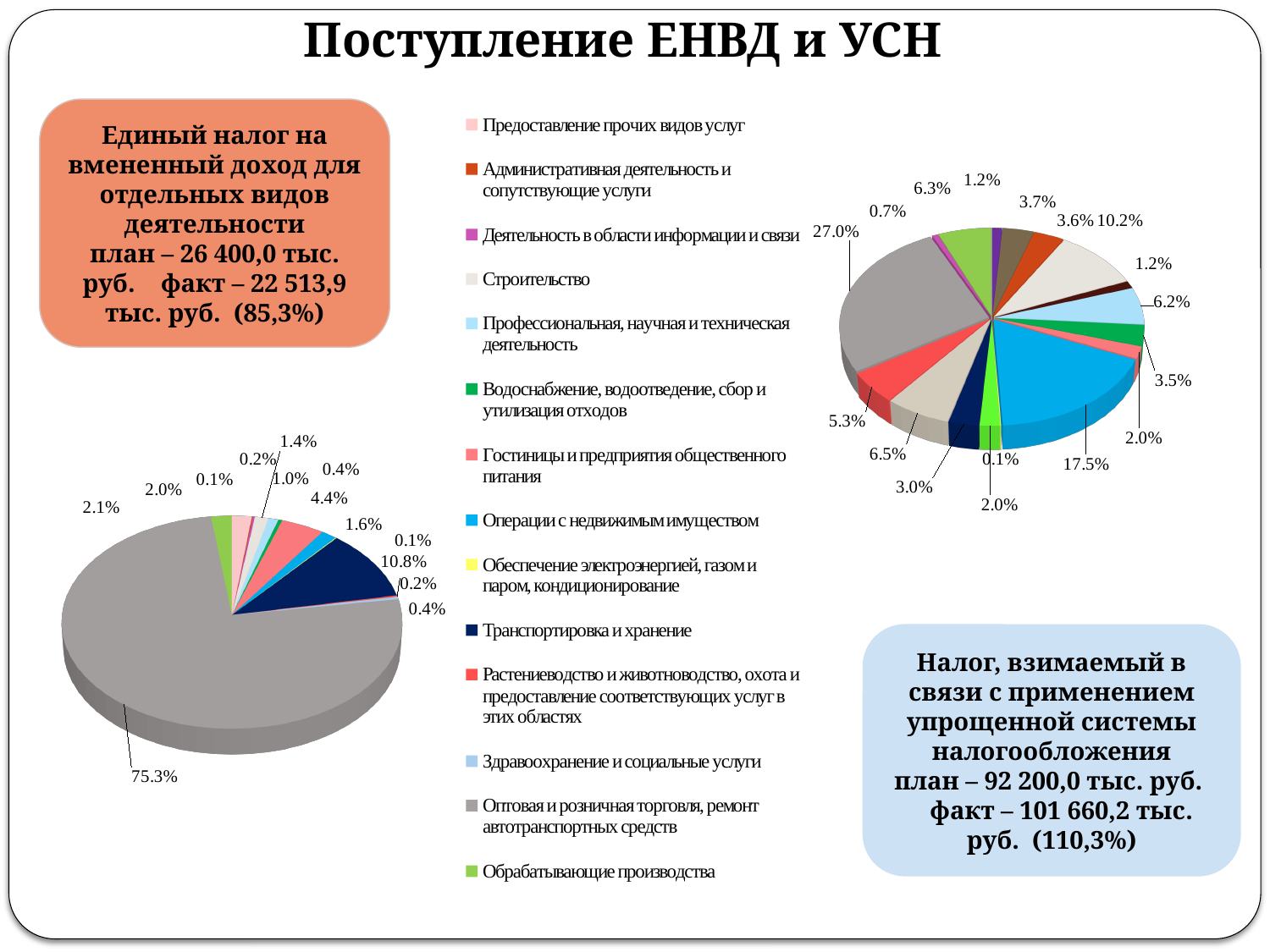
In the left pie chart (ЕНВД), what is the share of Оптовая и розничная торговля, ремонт автотранспортных средств? 75.3% In the right pie chart (УСН), what is the share of Операции с недвижимым имуществом? 17.5% In the left pie chart (ЕНВД), which category has the largest share? Оптовая и розничная торговля, ремонт автотранспортных средств In the right pie chart (УСН), which category has the largest share? Оптовая и розничная торговля, ремонт автотранспортных средств How many categories does the shared legend between the two pie charts list? 14 In the right pie chart (УСН), what is the share of Обрабатывающие производства? 6.3% What type of chart is used on the left side of the slide for ЕНВД? Pie chart In the left pie chart (ЕНВД), what is the difference between the shares of Оптовая и розничная торговля and Транспортировка и хранение? 64.5% Which chart shows a larger share for Обрабатывающие производства, the left (ЕНВД) or the right (УСН) pie chart? The right (УСН) pie chart